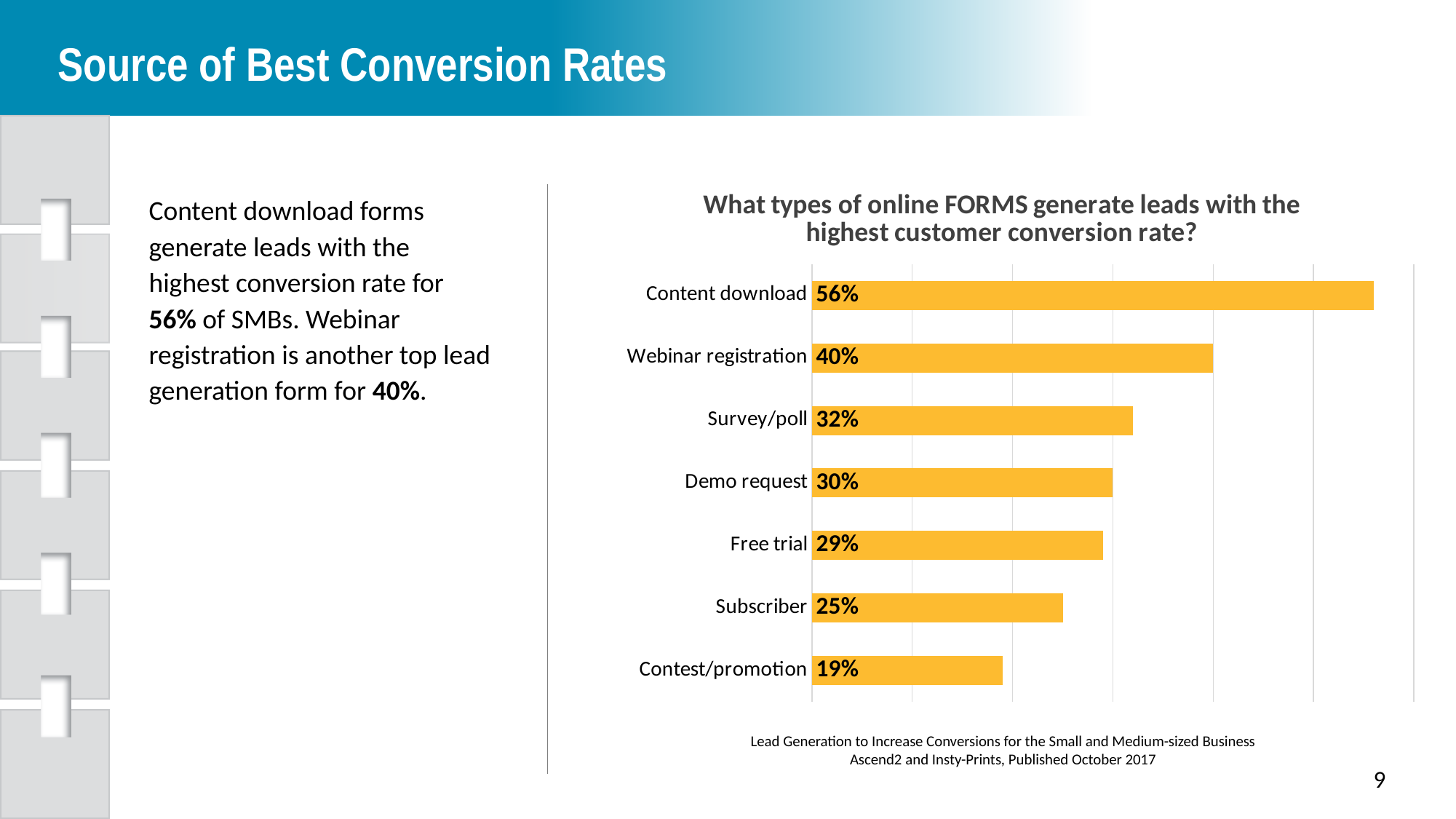
Which form type has the lowest value? Contest/promotion What is the difference between the values for Subscriber and Contest/promotion? 6% What is the value for Survey/poll? 32% What is the value for Content download? 56% What colour are the bars in the chart? Yellow What is the title of the chart? What types of online FORMS generate leads with the highest customer conversion rate? How many form types are shown in the chart? 7 Which form type has the highest value? Content download What is the value for Contest/promotion? 19% Which is larger, the value for Free trial or the value for Subscriber? Free trial What kind of chart is shown on the slide? Bar chart What is the difference between the values for Content download and Webinar registration? 16%